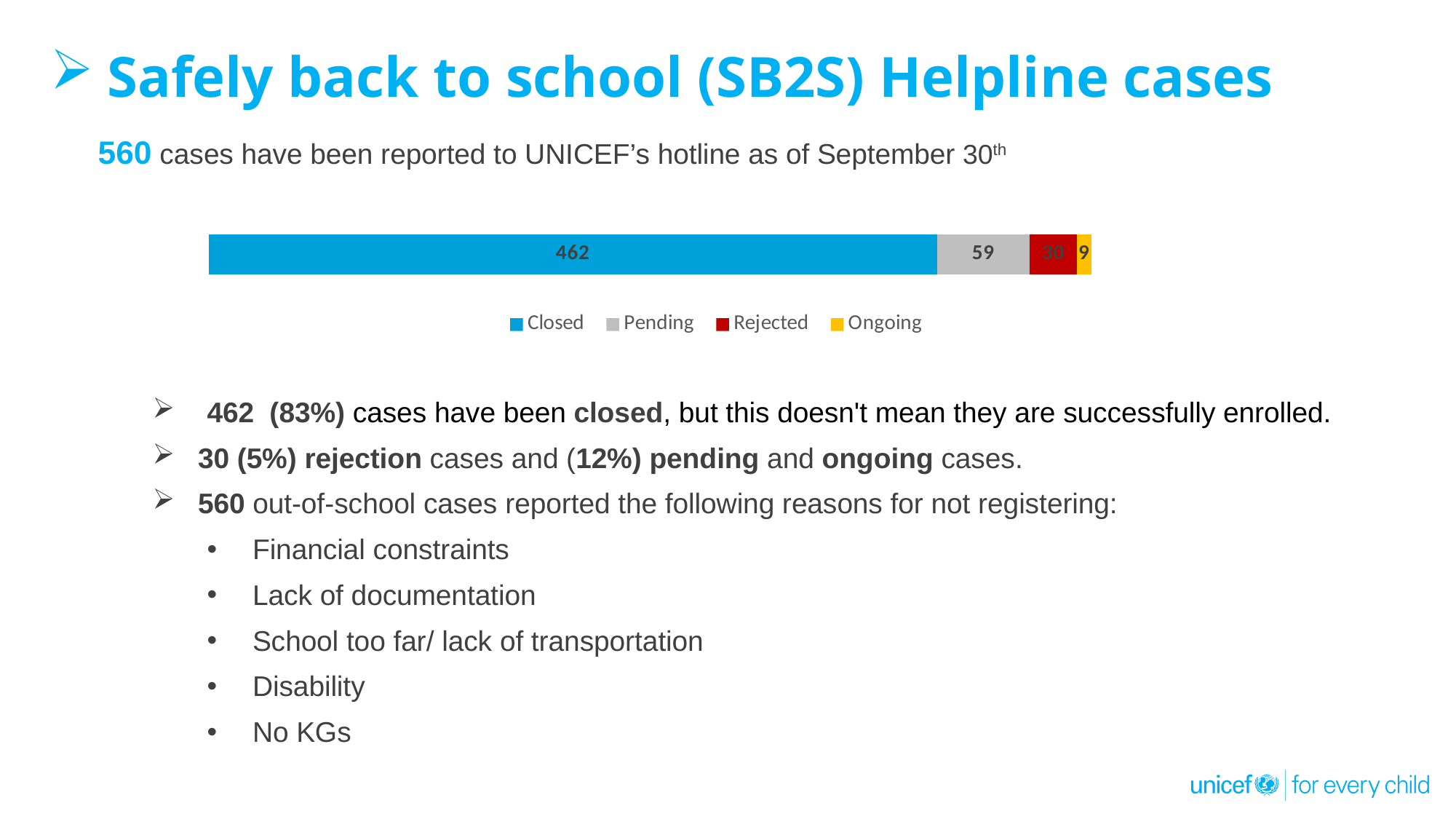
How many series does the legend list? 4 What is the value for Ongoing cases in the chart? 9 Which series has the highest value in the chart? Closed What is the value for Rejected cases in the chart? 30 What is the difference between the Pending and Rejected values? 29 Which is larger, the Rejected value or the Ongoing value? Rejected Which series has the lowest value in the chart? Ongoing What kind of chart is shown on the slide? Stacked bar chart What is the difference between the Closed and Pending values? 403 What is the value for Pending cases in the chart? 59 What is the value for Closed cases in the chart? 462 What is the total of all segments in the stacked bar? 560